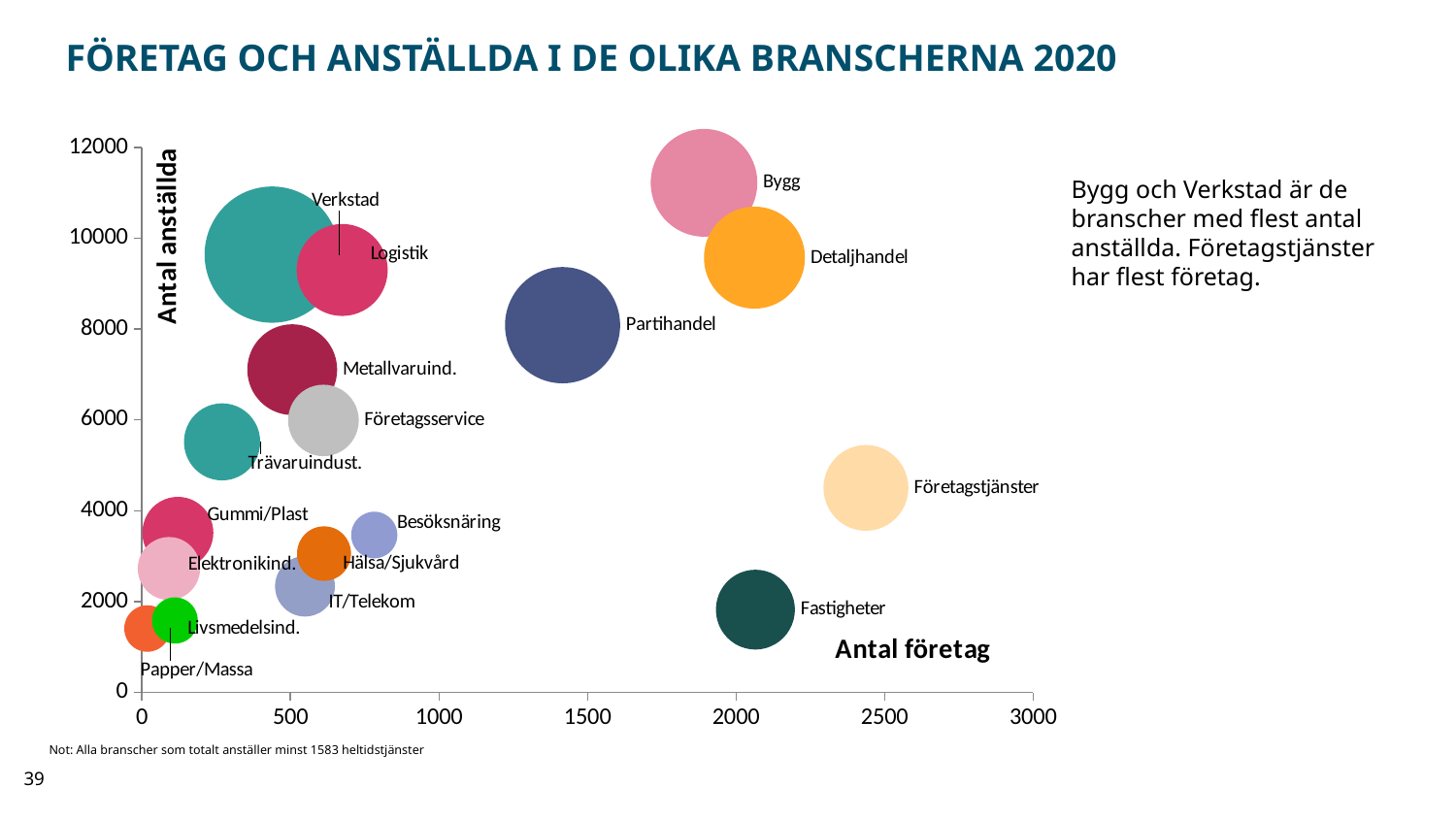
Which has more employees (Antal anställda), Bygg or Fastigheter? Bygg Is the number of companies (Antal företag) for Partihandel greater or less than 1000? greater Which industry has the highest number of companies (Antal företag) in the chart? Företagstjänster What is the title of the vertical axis of the chart? Antal anställda How many industries (bubbles) are plotted in the chart? 17 Is the number of companies (Antal företag) for Företagstjänster greater or less than 2000? greater Is the number of employees (Antal anställda) for Bygg greater or less than 10000? greater Which industry has the lowest number of companies (Antal företag) in the chart? Papper/Massa Which has more companies (Antal företag), Företagstjänster or Verkstad? Företagstjänster What kind of chart is shown on the slide? Bubble chart Which industry has the highest number of employees (Antal anställda) in the chart? Bygg